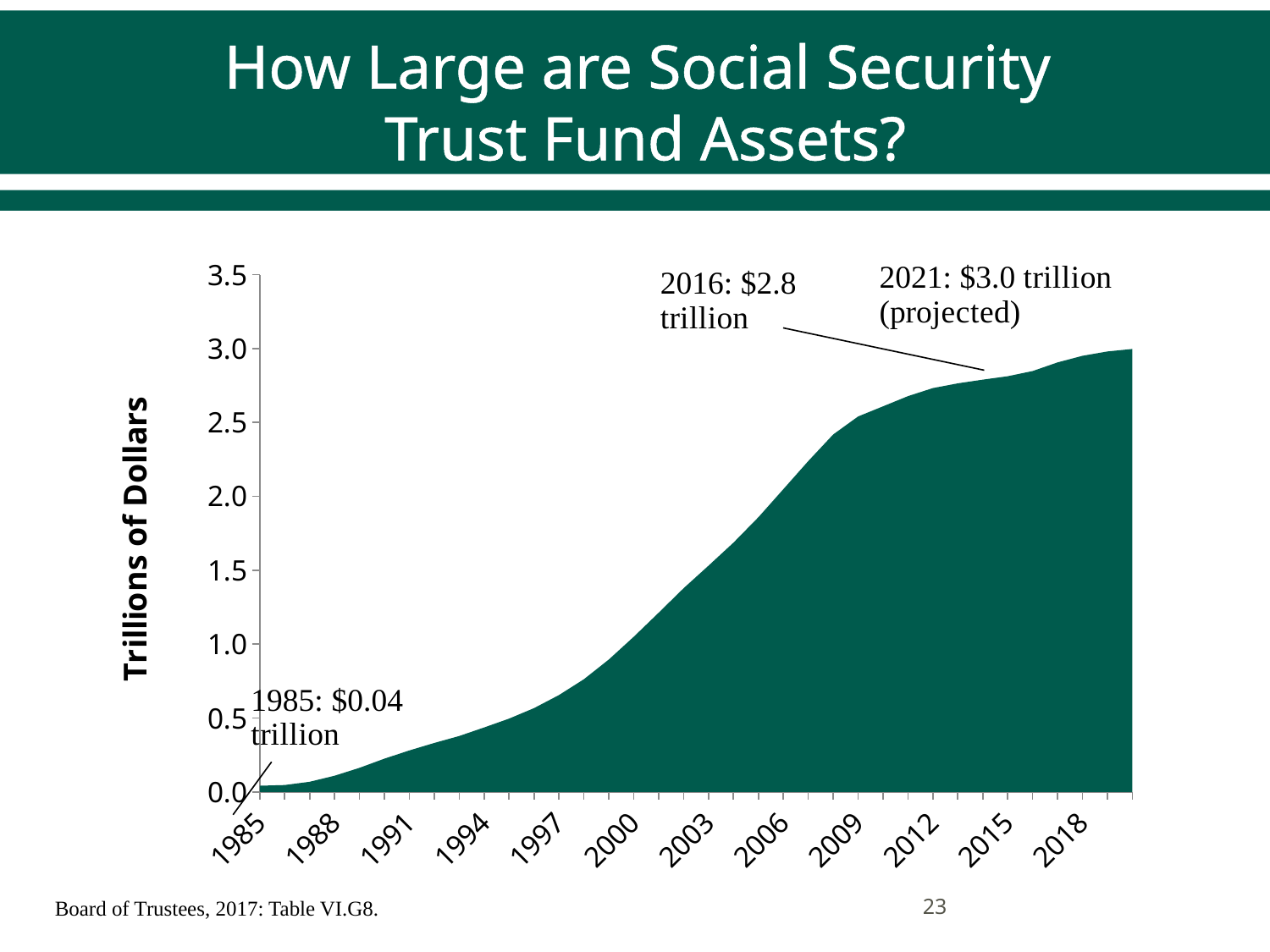
What is the projected value of Social Security Trust Fund assets in 2021? $3.0 trillion Is the value for 2003 greater or less than 1.0 trillion dollars? greater What kind of chart is shown on the slide? Area chart Is the value for 2009 greater or less than 2.0 trillion dollars? greater What source is cited for the chart? Board of Trustees, 2017: Table VI.G8. Do trust fund assets generally rise or fall from 1985 to 2021? Rise By how much are trust fund assets projected to grow from 2016 to 2021? $0.2 trillion Which is larger, the 2016 value or the projected 2021 value? 2021 Is the value for 1991 greater or less than 0.5 trillion dollars? less What was the value of Social Security Trust Fund assets in 1985? $0.04 trillion What is the label on the vertical axis? Trillions of Dollars What was the value of Social Security Trust Fund assets in 2016? $2.8 trillion